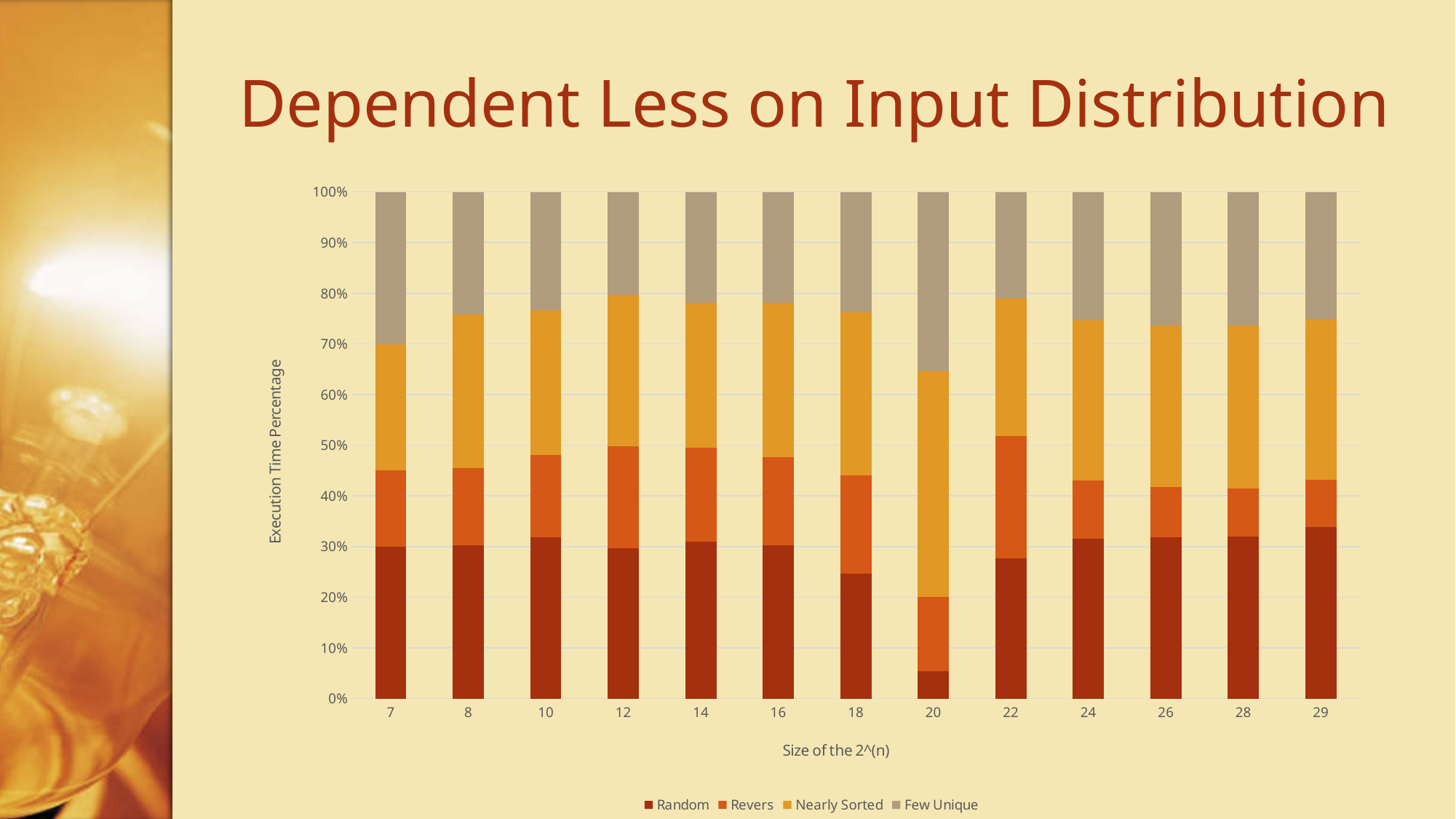
What is the label of the y axis? Execution Time Percentage Is the Random share for size 29 greater or less than 30%? greater How many series does the chart's legend list? 4 Which size has the largest Nearly Sorted share? 20 Which size has the smallest Random share? 20 Which has the larger Random share, size 7 or size 20? 7 Is the Few Unique share for size 20 greater or less than 30%? greater What is the title of the chart on the slide? Dependent Less on Input Distribution How many categories are shown along the x axis of the chart? 13 Is the Random share for size 20 greater or less than 10%? less What kind of chart is shown on the slide? Stacked bar chart What does each stacked bar total? 100%